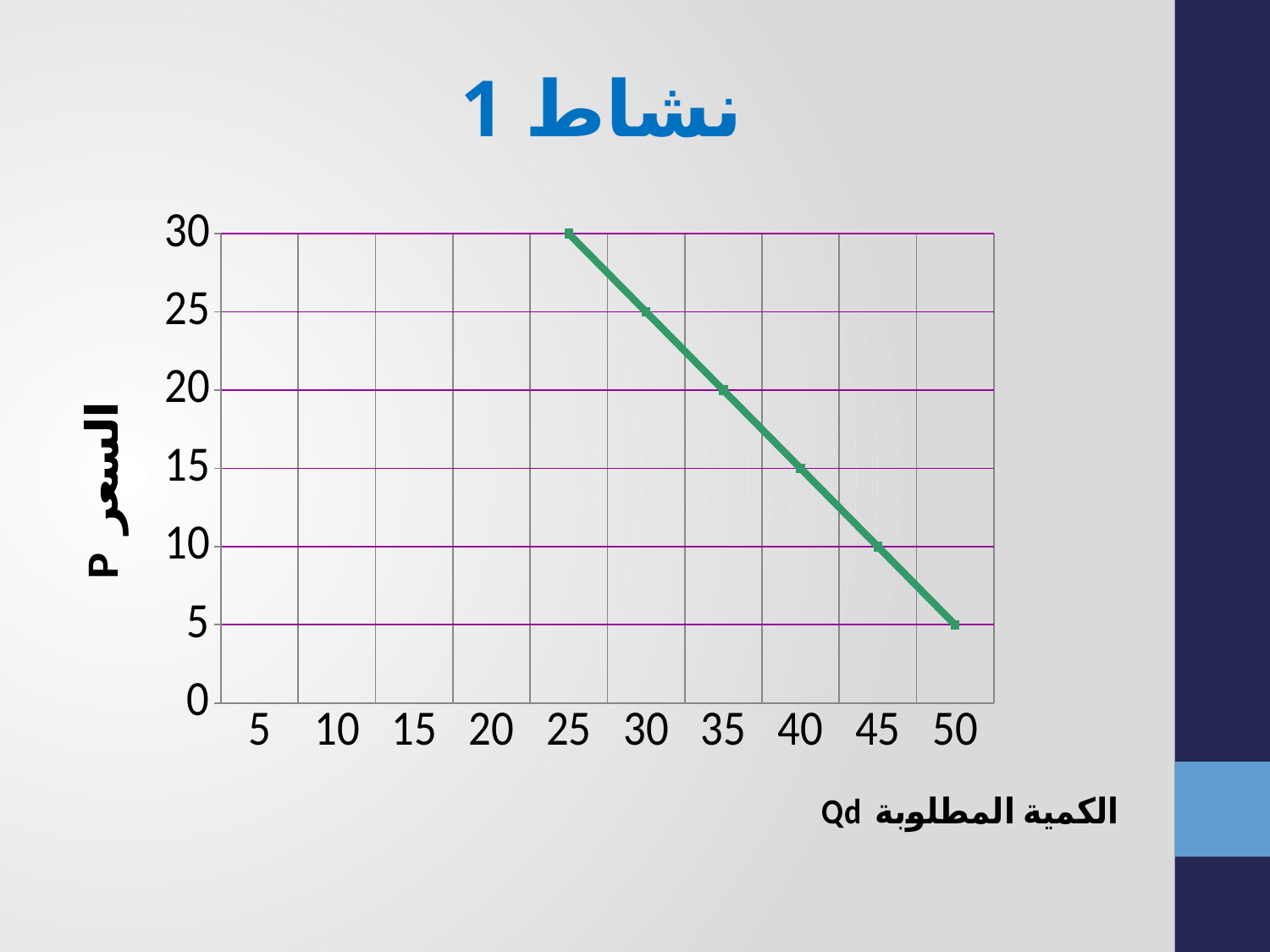
What is the price (P) when the quantity demanded (Qd) is 45? 10 What is the price (P) when the quantity demanded (Qd) is 35? 20 What is the difference in price between a quantity demanded of 30 and a quantity demanded of 40? 10 What is the price (P) when the quantity demanded (Qd) is 25? 30 Which has a higher price: a quantity demanded of 30 or a quantity demanded of 45? 30 What kind of chart is shown on the slide? line chart At which quantity demanded (Qd) is the price highest? 25 At which quantity demanded (Qd) is the price lowest? 50 What is the price (P) when the quantity demanded (Qd) is 50? 5 Does the price rise or fall as the quantity demanded increases along the x axis? fall How many data points are plotted on the line? 6 What is the title of the chart? نشاط 1